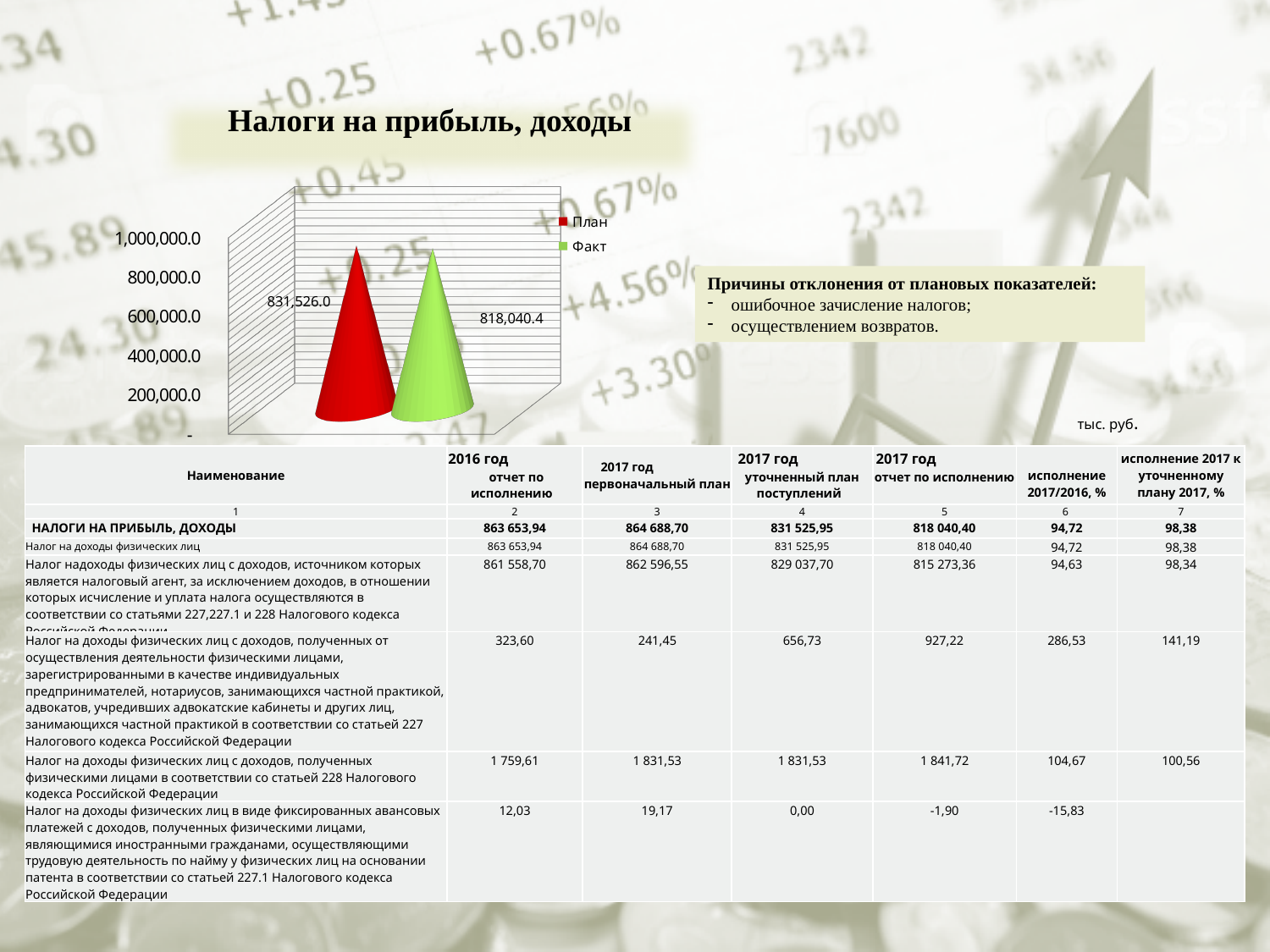
Is the value for Факт greater or less than 1,000,000.0? less What is the value of the Факт series in the chart? 818,040.4 What kind of chart is shown on the slide? Bar chart What colour represents the Факт series in the chart? Green Is the value for План greater or less than 800,000.0? greater Which series has the highest value in the chart? План What is the value of the План series in the chart? 831,526.0 What is the difference between the План value and the Факт value in the chart? 13,485.6 What colour represents the План series in the chart? Red How many series does the chart legend list? 2 Which series has the higher value in the chart, План or Факт? План Which series has the lowest value in the chart? Факт